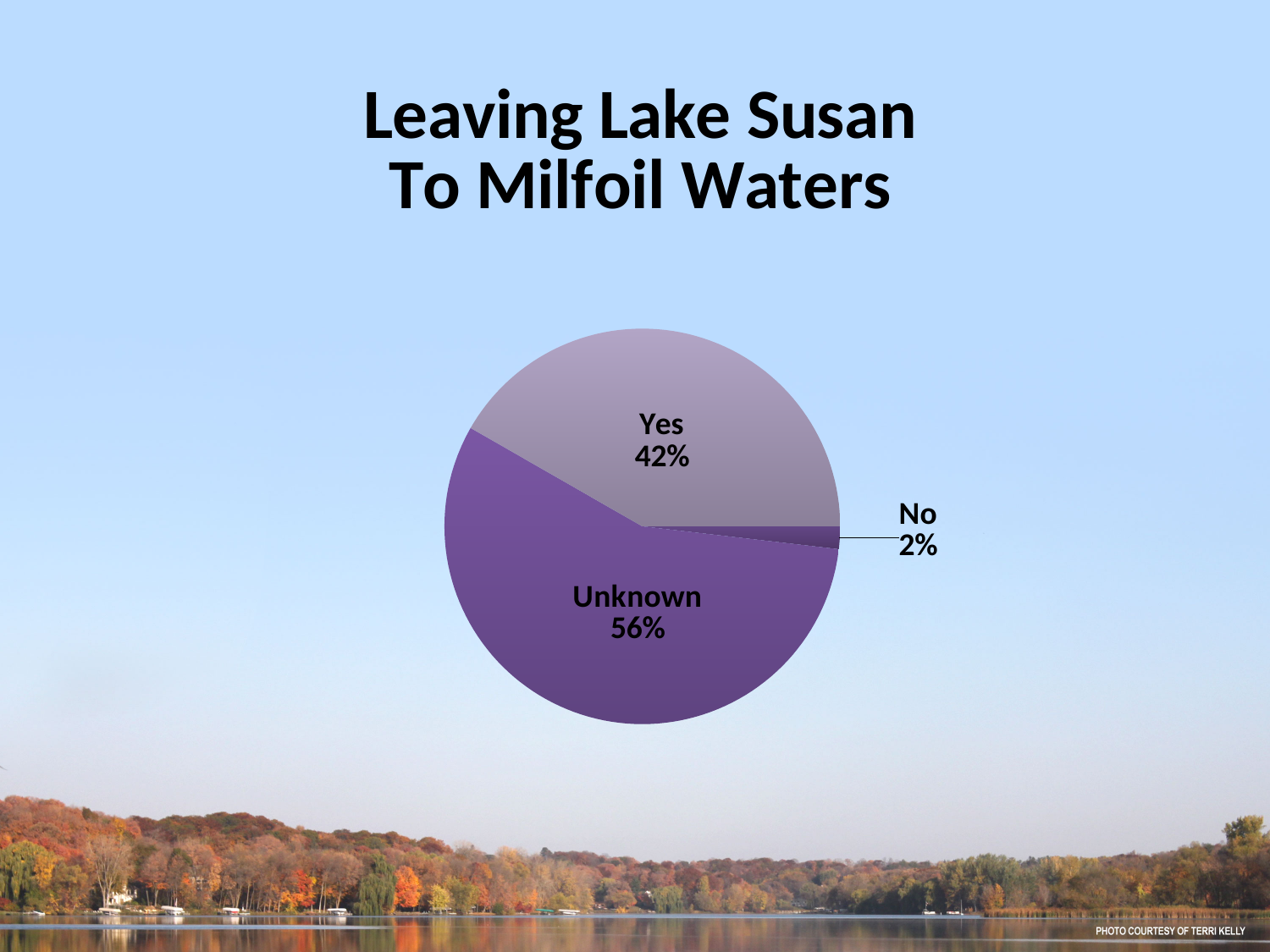
What percentage of the pie is labelled No? 2% How many slices does the pie chart have? 3 What is the title of the chart? Leaving Lake Susan To Milfoil Waters What kind of chart is shown on the slide? pie chart Which is larger, the Yes slice or the Unknown slice? Unknown What percentage of the pie is labelled Unknown? 56% Which slice of the pie is the smallest? No What percentage of the pie is labelled Yes? 42% Which slice of the pie is the largest? Unknown What share of the pie do the Yes and No slices make up together? 44% What is the difference in percentage points between the Unknown slice and the Yes slice? 14 What is the difference in percentage points between the Yes slice and the No slice? 40